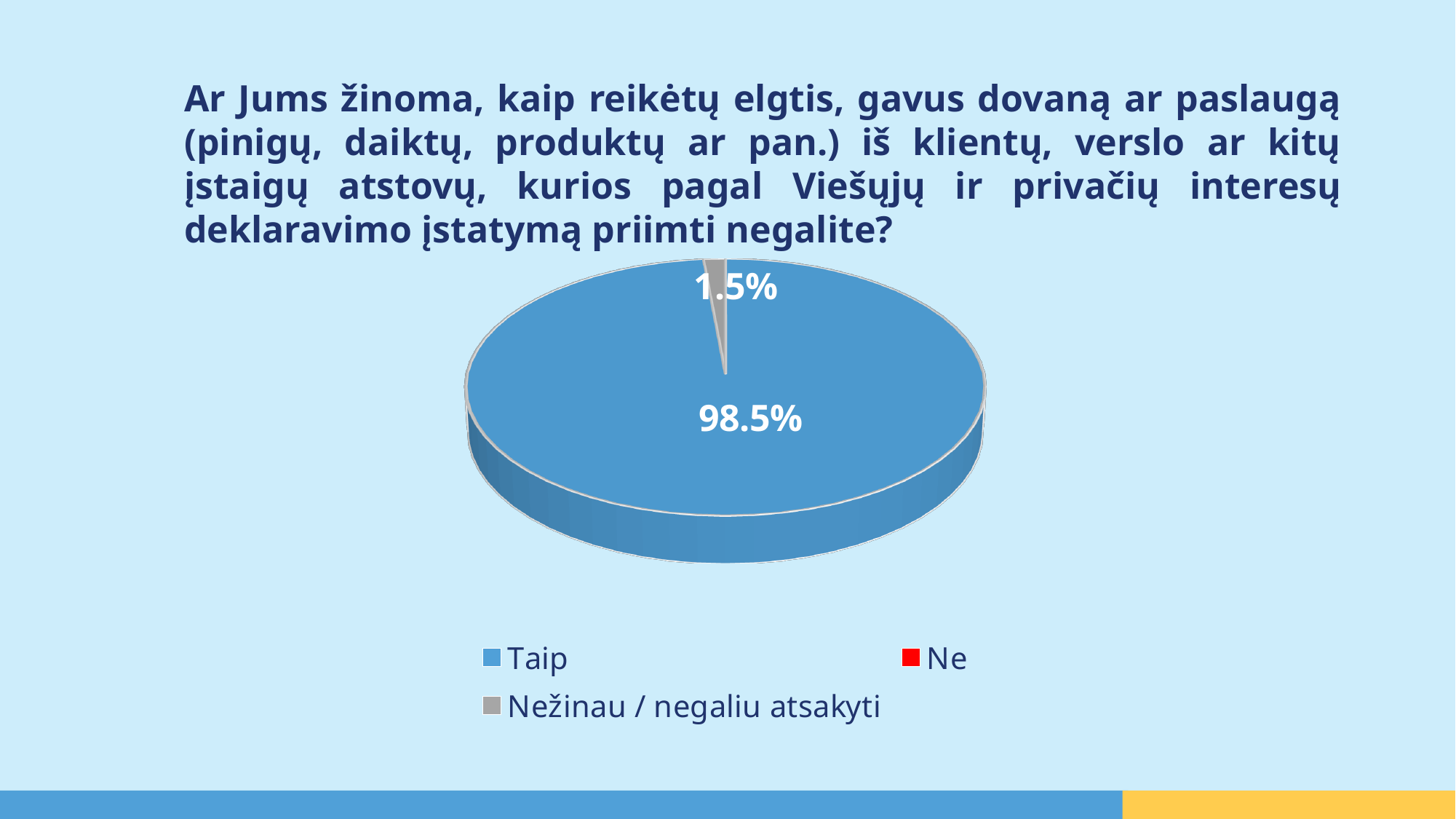
What is the difference in percentage points between the "Taip" slice and the "Nežinau / negaliu atsakyti" slice? 97.0% Which legend entry is shown in red? Ne What share of respondents answered "Taip"? 98.5% Which answer category has the largest slice of the pie? Taip What share of the pie does the "Taip" slice take up? 98.5% Which is larger, the share for "Taip" or the share for "Nežinau / negaliu atsakyti"? Taip What share of respondents answered "Nežinau / negaliu atsakyti"? 1.5% How many entries does the chart legend list? 3 What colour is the "Taip" slice of the pie? Blue What kind of chart is shown on the slide? Pie chart How many slices with printed percentage labels are visible in the pie? 2